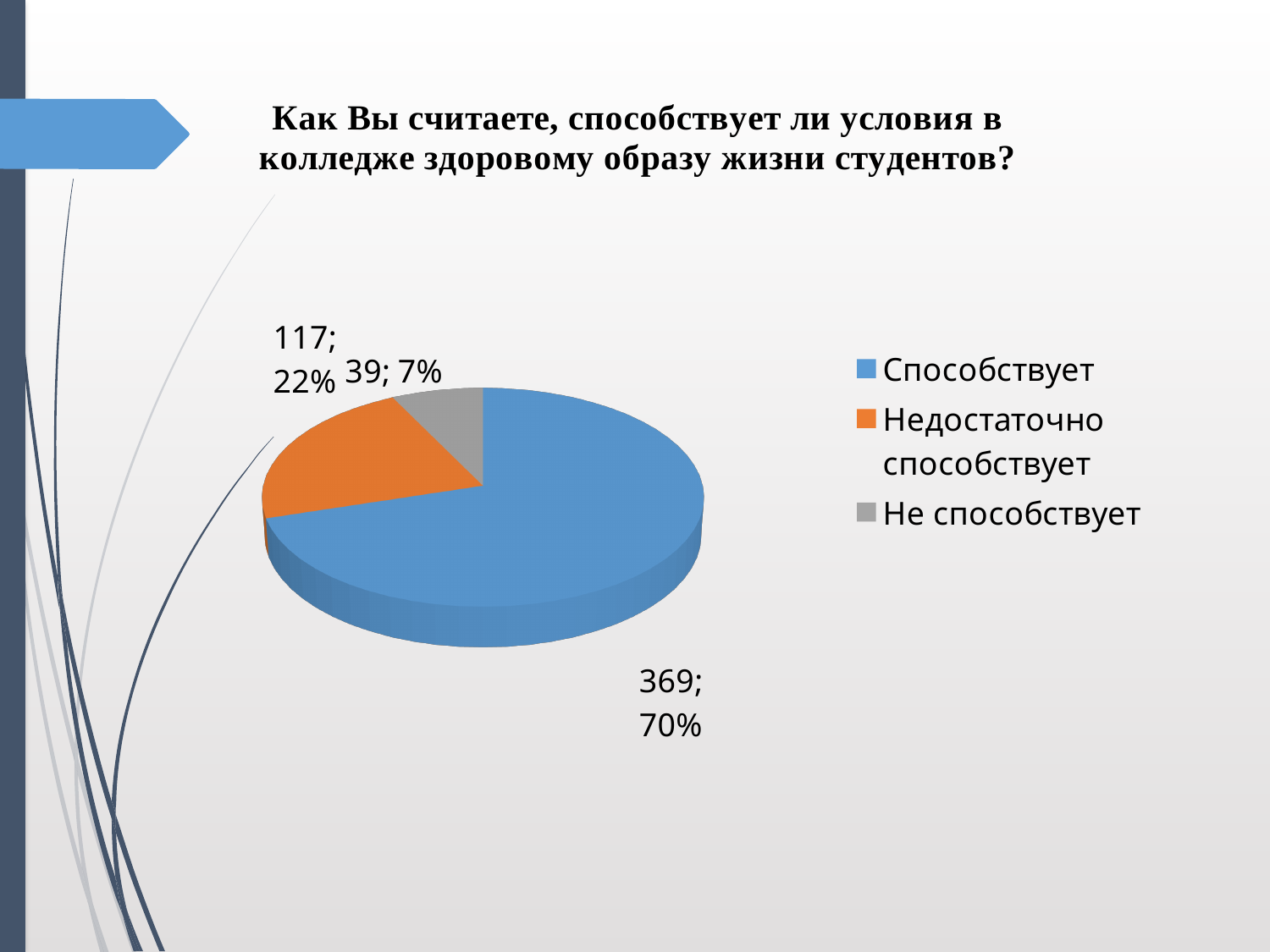
Which category has the largest slice? Способствует What share of the pie does Способствует take? 70% How many slices does the pie chart have? 3 What share of the pie does Не способствует take? 7% Which colour represents Недостаточно способствует in the legend? orange What is the difference between the values for Способствует and Недостаточно способствует? 252 What is the value for Способствует? 369 What kind of chart is shown on the slide? pie chart What is the value for Недостаточно способствует? 117 Which category has the smallest slice? Не способствует How many entries does the legend list? 3 What is the value for Не способствует? 39